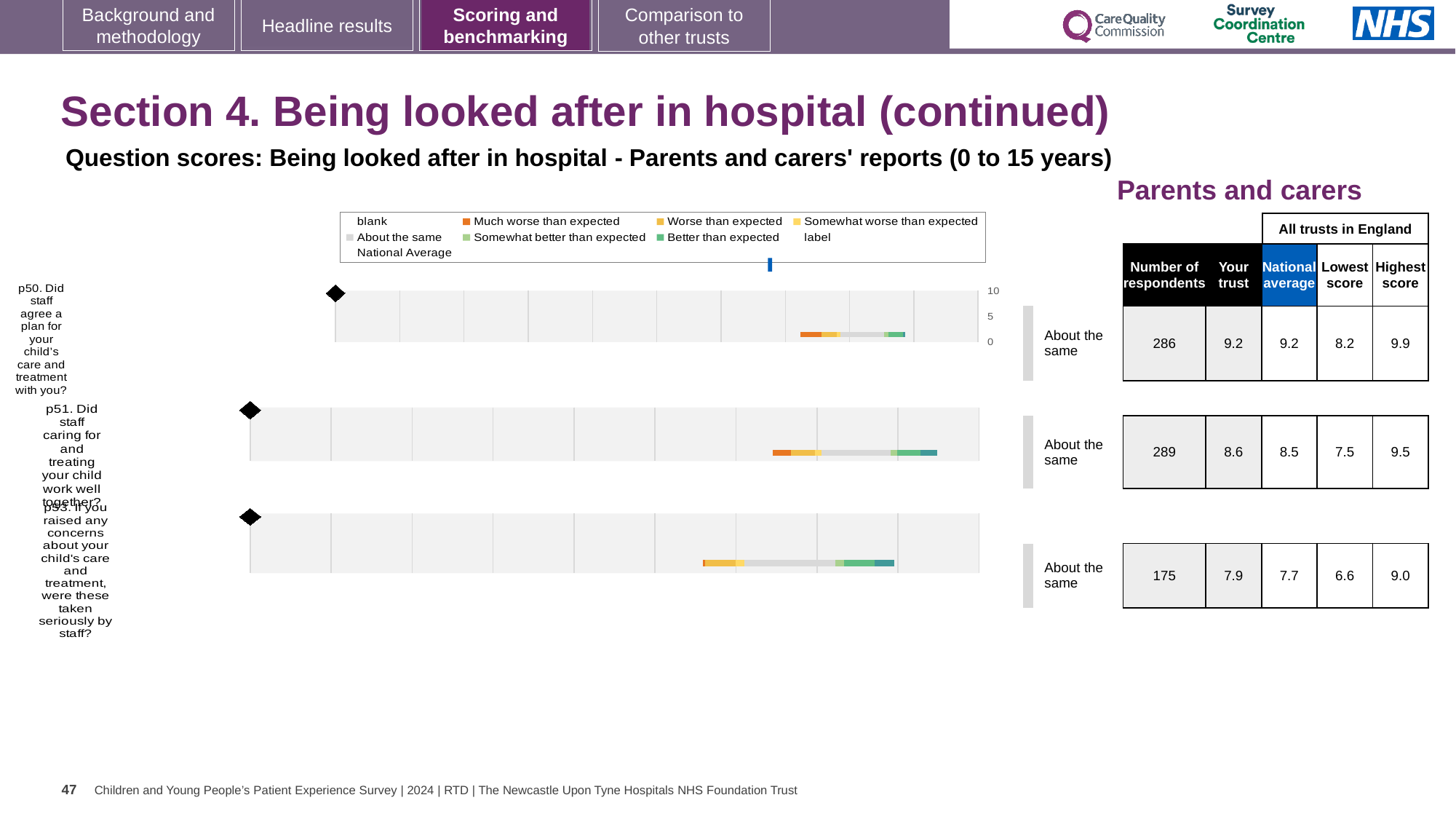
What kind of chart is used to show the benchmarking for each question on this slide? bar chart Which question has the lowest 'Your trust' score on this slide? p53 Which is larger: the 'Your trust' score for p50 or for p53? p50 In the chart legend, which colour represents 'Much worse than expected'? orange What is the difference between the 'Your trust' score and the national average for p51? 0.1 Which question has the highest 'Your trust' score on this slide? p50 How many respondents answered p53 (If you raised any concerns about your child's care and treatment, were these taken seriously by staff?)? 175 What is the highest score among all trusts in England for p53? 9.0 What is the 'Your trust' score for p50 (Did staff agree a plan for your child's care and treatment with you?)? 9.2 What is the national average score for p51 (Did staff caring for and treating your child work well together?)? 8.5 What benchmark category is shown for p50? About the same How many questions (chart rows) are plotted on this slide? 3